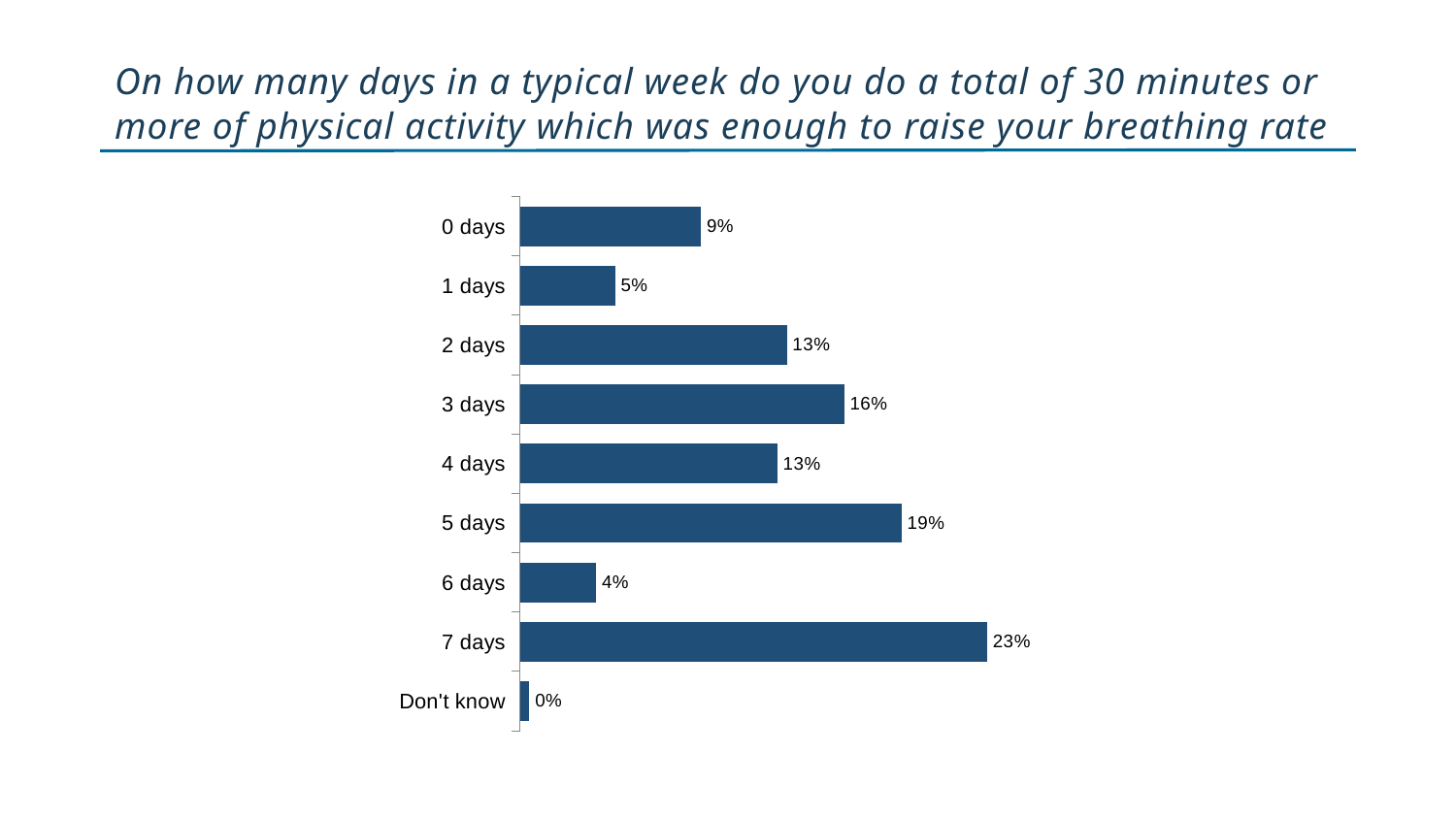
Which is larger, the value for 2 days or the value for 6 days? 2 days What is the difference between the values for 0 days and 1 days? 4% What kind of chart is shown on the slide? Bar chart Which is larger, the value for 5 days or the value for 3 days? 5 days What percentage is shown for 6 days? 4% Which two categories share the same value of 13%? 2 days and 4 days How many categories are shown on the chart? 9 Which category has the highest value? 7 days What is the difference between the values for 7 days and 5 days? 4% What is the value shown for 3 days? 16% What percentage of respondents reported 7 days? 23% Which category has the lowest value? Don't know